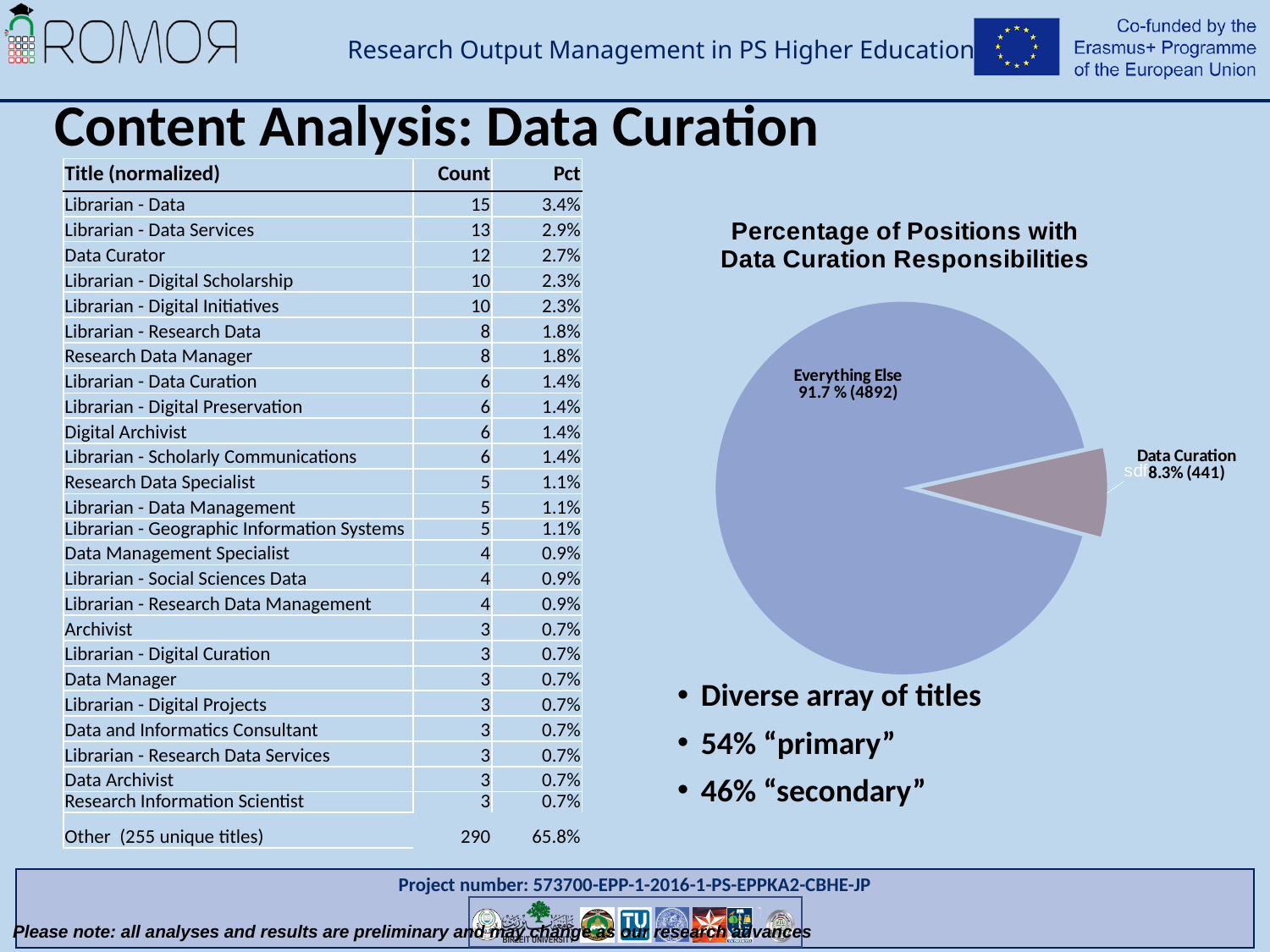
What kind of chart is shown on the slide? pie chart What is the count shown for the Data Curation slice? 441 Which slice is larger, Data Curation or Everything Else? Everything Else What is the title of the pie chart? Percentage of Positions with Data Curation Responsibilities Which slice of the pie chart is the largest? Everything Else What share of the pie does the Data Curation slice represent? 8.3% What is the count shown for the Everything Else slice? 4892 Which slice of the pie chart is the smallest? Data Curation What is the total count across both slices of the pie chart? 5333 How many slices does the pie chart have? 2 What share of the pie does the Everything Else slice represent? 91.7 % What is the difference in count between the Everything Else slice and the Data Curation slice? 4451